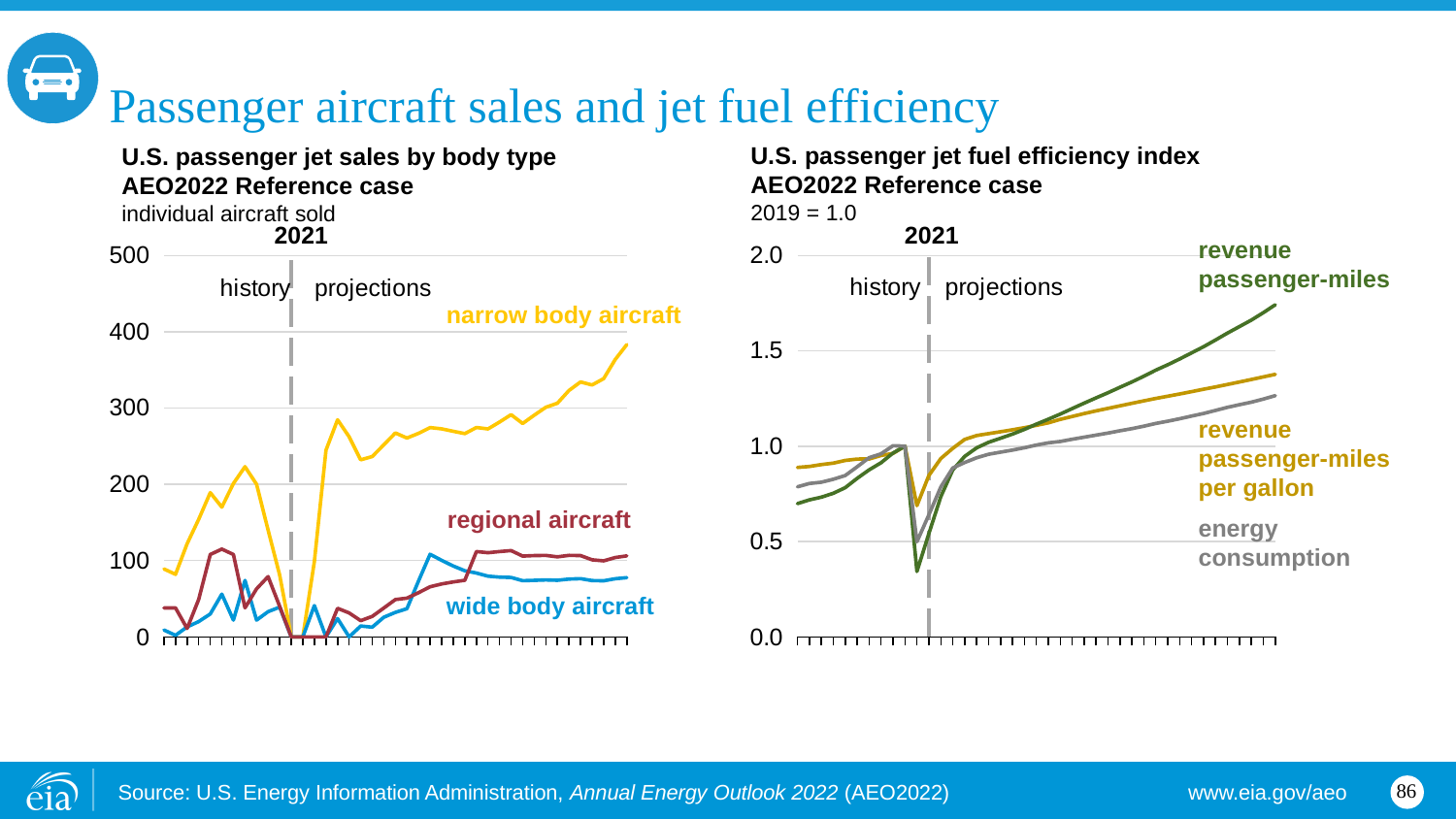
How many series are plotted on the 'U.S. passenger jet sales by body type' chart? 3 On the 'U.S. passenger jet fuel efficiency index' chart, which series has the highest value at the end of the projection period? revenue passenger-miles On the 'U.S. passenger jet fuel efficiency index' chart, is the value for revenue passenger-miles at the end of the projection period greater or less than 1.5? greater On the 'U.S. passenger jet sales by body type' chart, which is larger at the end of the projection period: regional aircraft or wide body aircraft? regional aircraft On the 'U.S. passenger jet fuel efficiency index' chart, does the revenue passenger-miles series rise or fall over the projection period? rise On the 'U.S. passenger jet sales by body type' chart, is the value for narrow body aircraft at the end of the projection period greater or less than 300? greater What kind of chart is the 'U.S. passenger jet sales by body type' chart on the left? line chart On the 'U.S. passenger jet fuel efficiency index' chart, which series has the lowest value at the end of the projection period? energy consumption On the 'U.S. passenger jet sales by body type' chart, is the value for wide body aircraft at the end of the projection period greater or less than 100? less What base year is the 'U.S. passenger jet fuel efficiency index' chart indexed to, according to its subtitle? 2019 = 1.0 On the 'U.S. passenger jet sales by body type' chart, which series has the highest value at the end of the projection period? narrow body aircraft How many series are plotted on the 'U.S. passenger jet fuel efficiency index' chart? 3